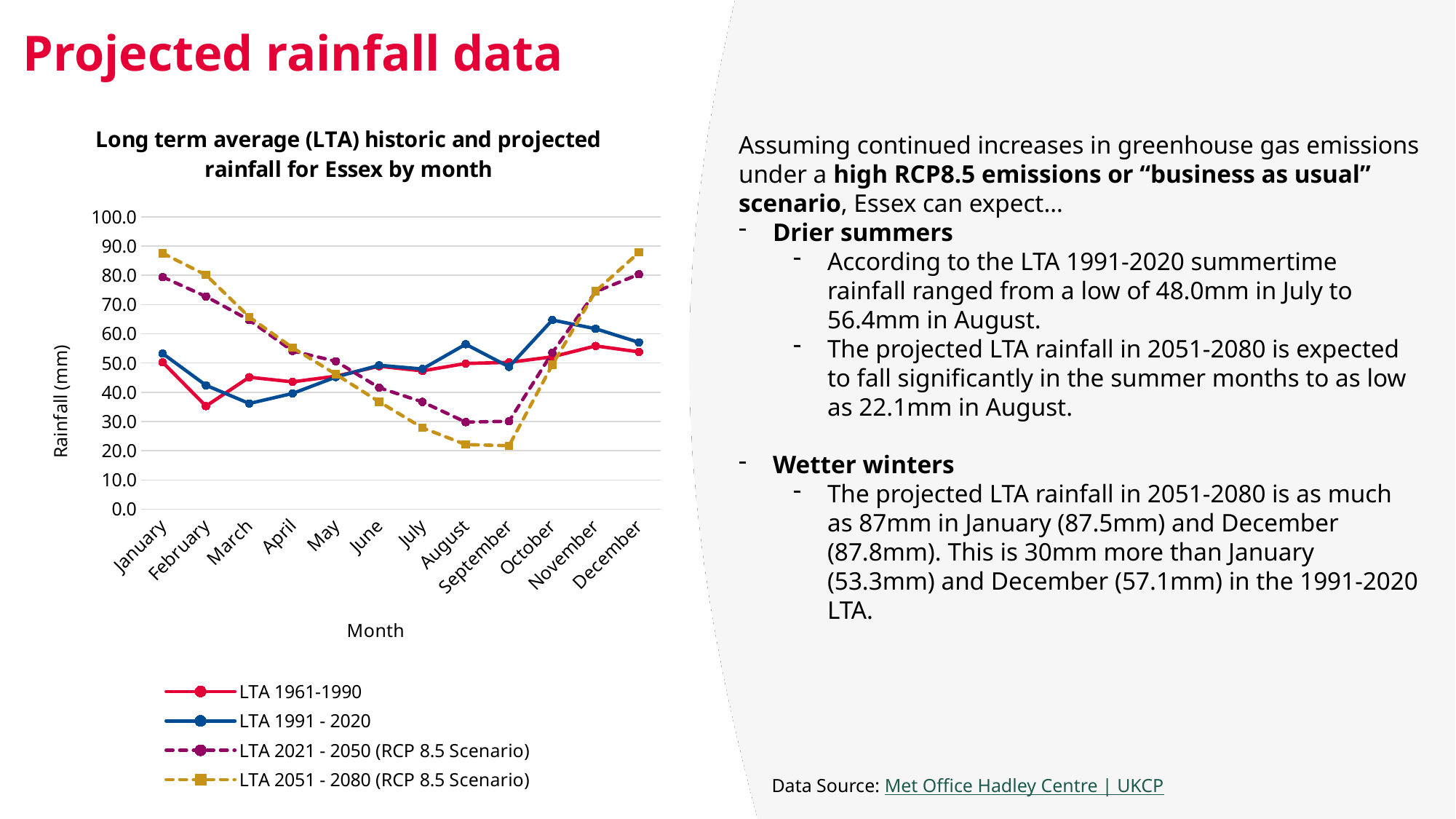
What is the label on the vertical axis of the chart? Rainfall (mm) Is the value for LTA 2051 - 2080 (RCP 8.5 Scenario) in January greater or less than 80.0? greater Is the value for LTA 1991 - 2020 in October greater or less than 60.0? greater In August, which series has the larger value: LTA 1991 - 2020 or LTA 2051 - 2080 (RCP 8.5 Scenario)? LTA 1991 - 2020 How many months are plotted along the x axis of the chart? 12 Is the value for LTA 2051 - 2080 (RCP 8.5 Scenario) in August greater or less than 30.0? less How many series does the chart legend list? 4 What kind of chart is shown on the slide? line chart Does the LTA 2051 - 2080 (RCP 8.5 Scenario) series rise or fall from January to August? fall Which month has the lowest value for the LTA 1991 - 2020 series? March Which month has the highest value for the LTA 1991 - 2020 series? October